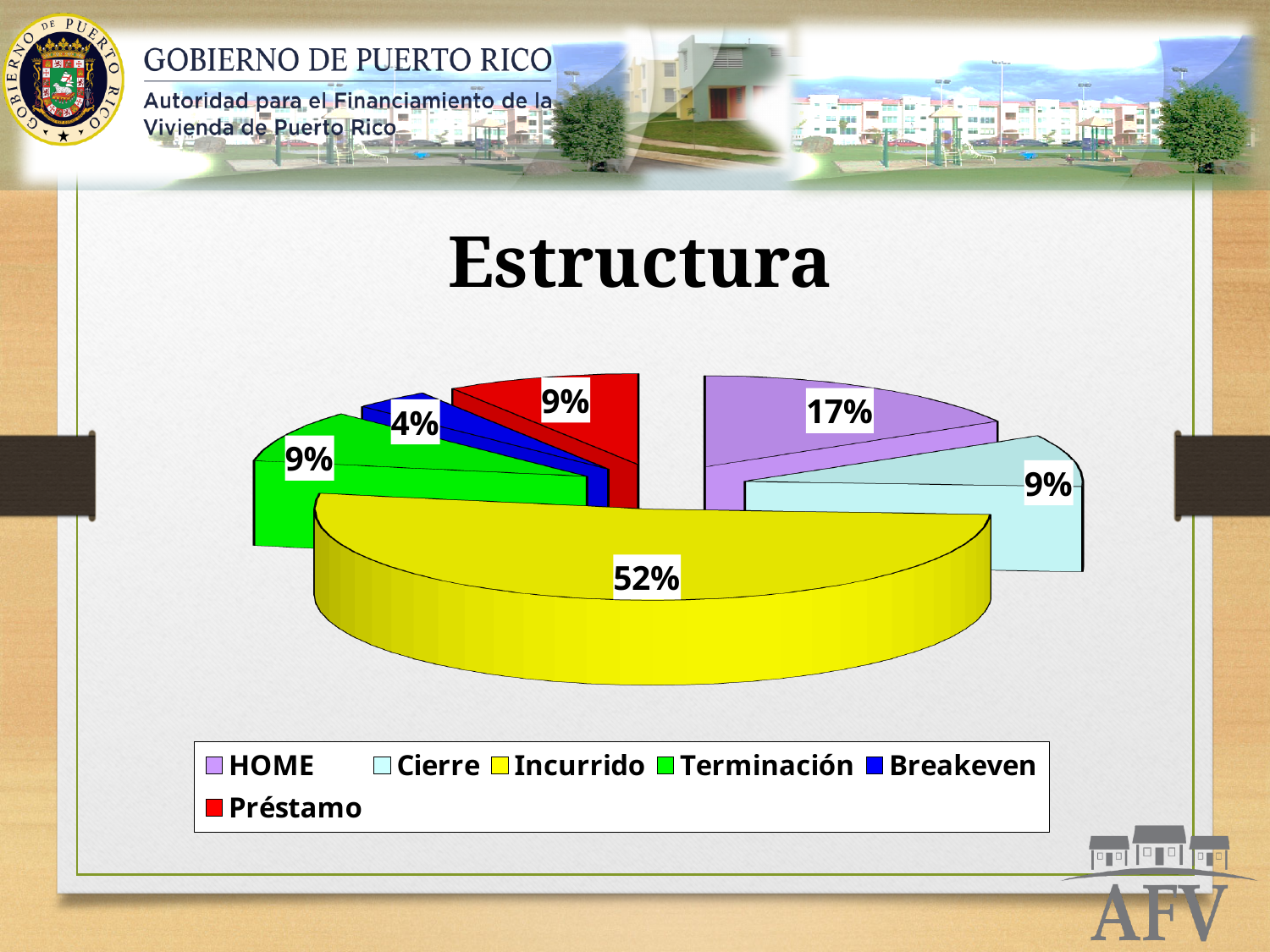
How many slices does the pie chart have? 6 Which category has the largest slice of the pie? Incurrido What share of the pie does HOME represent? 17% What share of the pie does Cierre represent? 9% What is the title of the chart? Estructura What is the difference in percentage points between Incurrido and HOME? 35 Which category has the smallest slice of the pie? Breakeven Which is larger, the HOME slice or the Préstamo slice? HOME What share of the pie does Breakeven represent? 4% Which colour represents Terminación in the legend? Green What kind of chart is shown on the slide? Pie chart